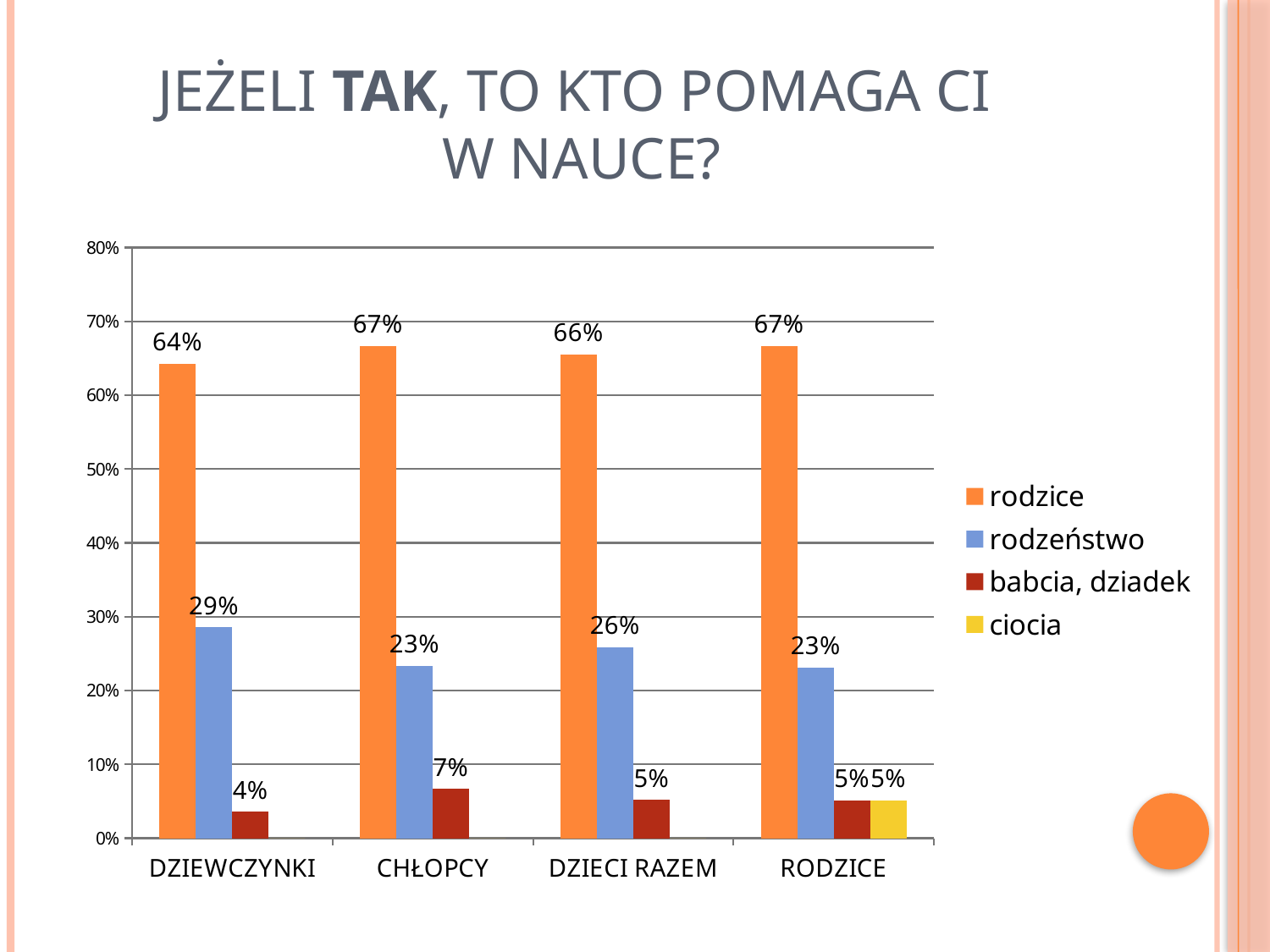
What is the value for babcia, dziadek in the CHŁOPCY category? 7% In which category is the rodzeństwo value highest? DZIEWCZYNKI What kind of chart is shown on the slide? bar chart In which category is the babcia, dziadek value lowest? DZIEWCZYNKI Which is larger: the rodzeństwo value for DZIEWCZYNKI or for CHŁOPCY? DZIEWCZYNKI What is the difference between the rodzice values for CHŁOPCY and DZIEWCZYNKI? 3% What is the value for ciocia in the RODZICE category? 5% What is the value for rodzice in the DZIEWCZYNKI category? 64% How many series does the legend list? 4 What is the value for rodzeństwo in the DZIECI RAZEM category? 26% Which legend entry is shown in orange? rodzice How many categories are shown on the x axis? 4